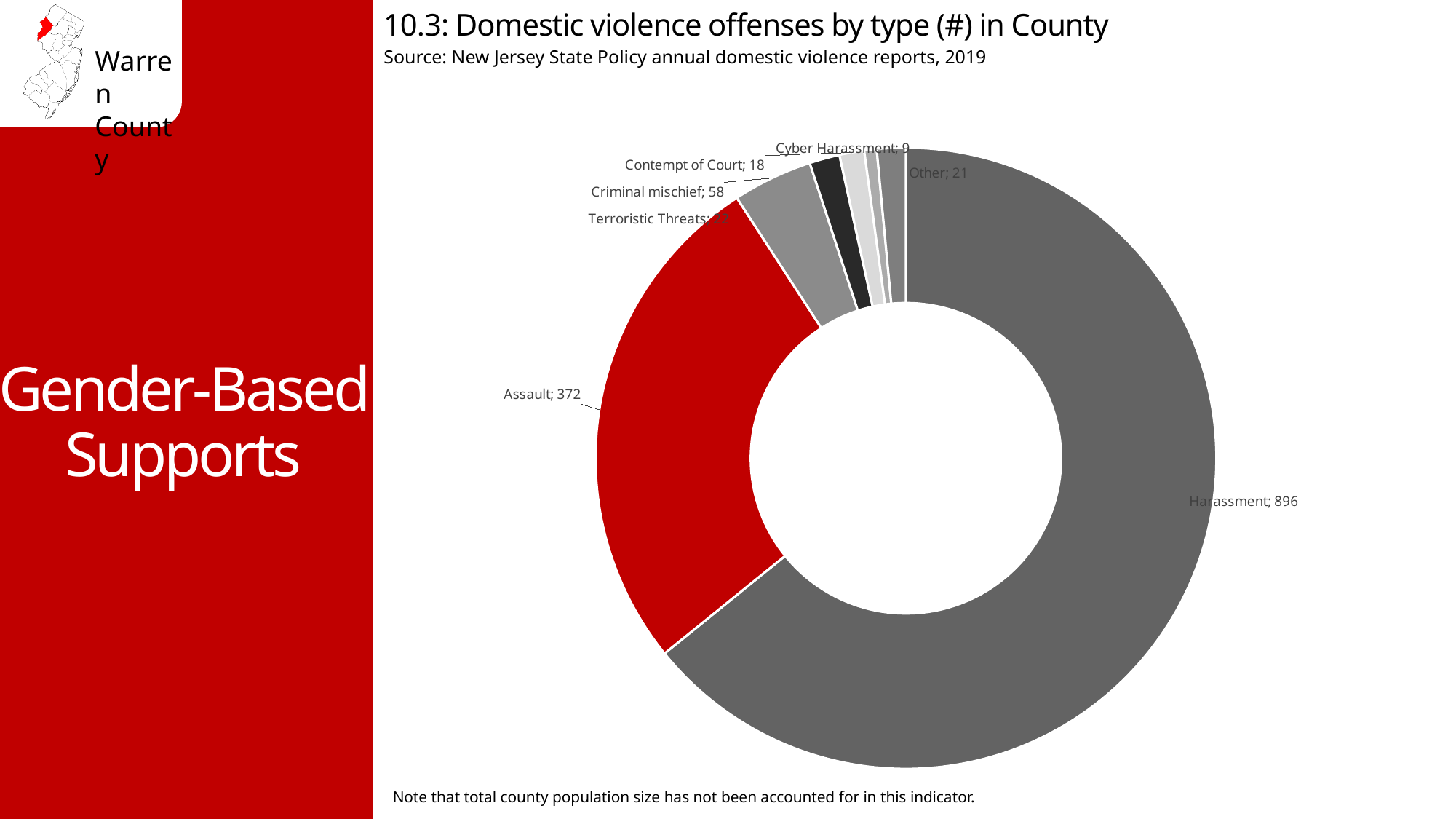
Which is larger, Criminal mischief or Contempt of Court? Criminal mischief What is the value for Other? 21 What is the value for Assault? 372 What is the value for Contempt of Court? 18 What is the value for Criminal mischief? 58 Which offense type has the highest value? Harassment What is the difference between the values for Harassment and Assault? 524 What is the value for Cyber Harassment? 9 How many offense categories are shown in the chart? 7 What kind of chart is shown on the slide? Pie chart (doughnut) Which offense type has the lowest value? Cyber Harassment What is the value for Harassment? 896